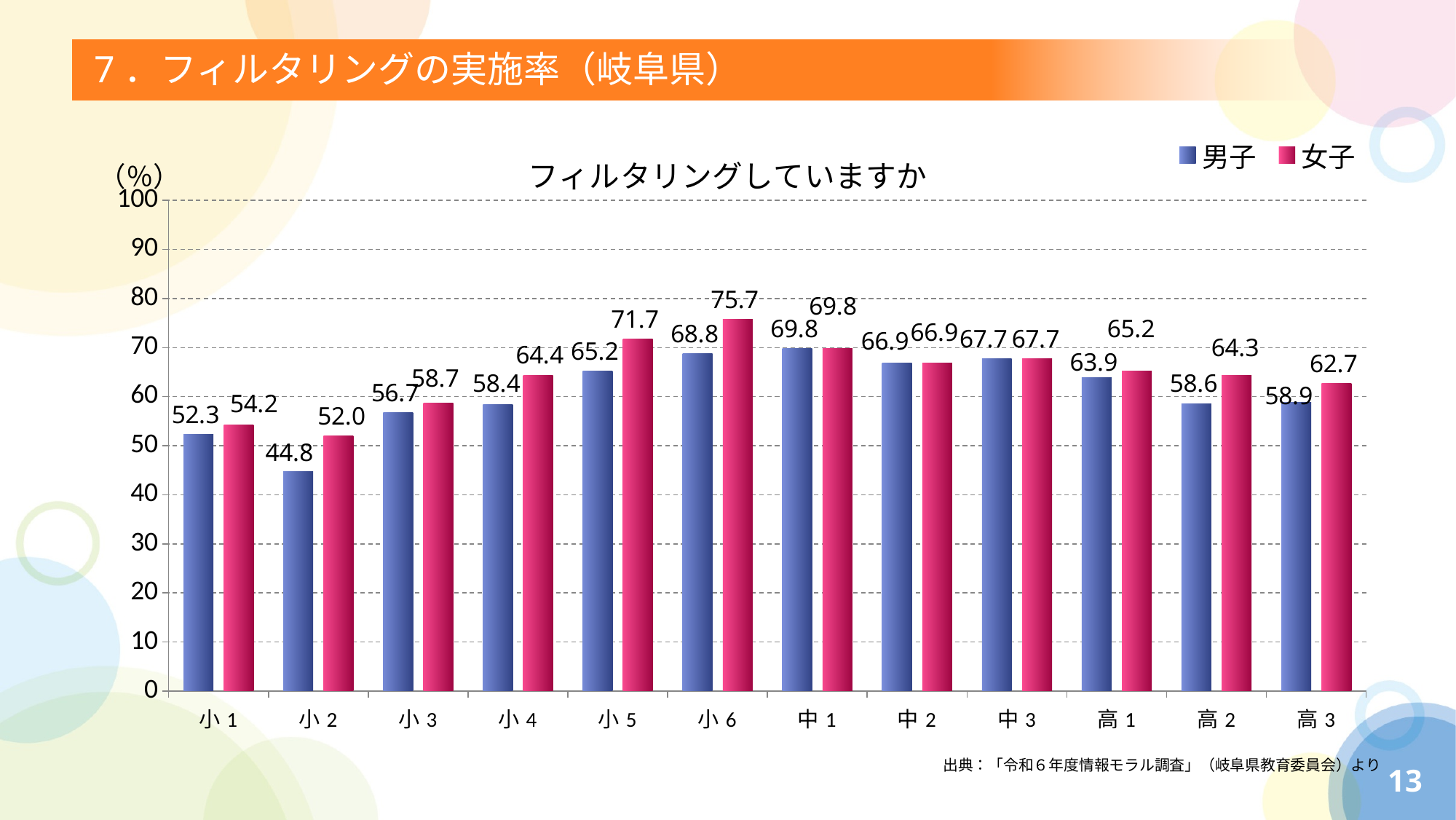
What is the value for 男子 at 小２? 44.8 Which category has the lowest value for 男子? 小２ What is the difference between 女子 and 男子 at 小６? 6.9 Which category has the highest value for 女子? 小６ Which category has the highest value for 男子? 中１ What is the value for 女子 at 高２? 64.3 What is the difference between 女子 and 男子 at 小２? 7.2 What is the value for 女子 at 小６? 75.7 Which is larger at 小５, the value for 男子 or for 女子? 女子 What type of chart is shown on the slide? Bar chart How many series does the legend list? 2 How many categories are shown on the x axis? 12